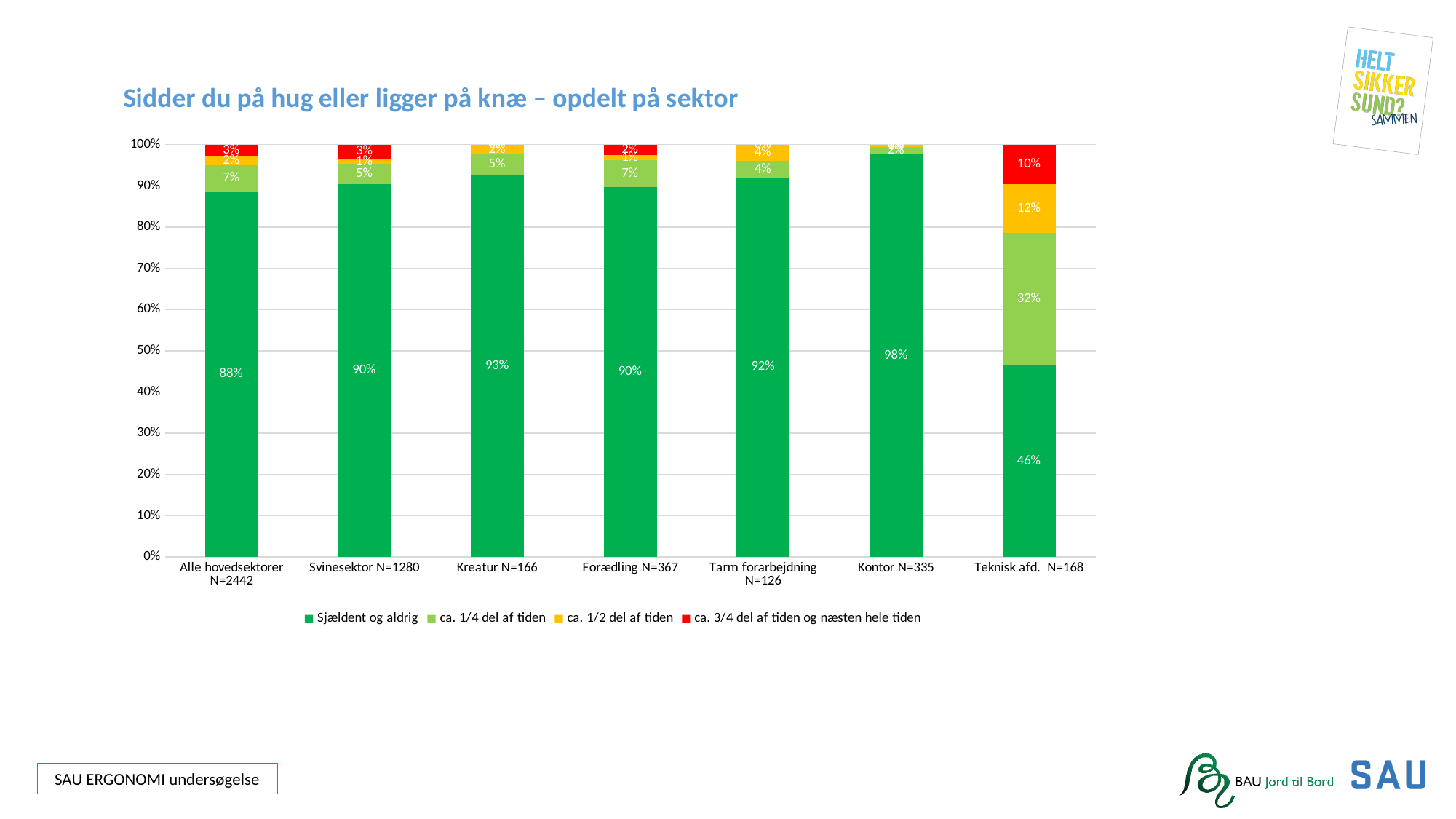
Which category has the highest value for "Sjældent og aldrig"? Kontor N=335 What is the value for "Sjældent og aldrig" in the Alle hovedsektorer N=2442 category? 88% How many series does the legend list? 4 Which is larger: the "Sjældent og aldrig" value for Kreatur N=166 or for Svinesektor N=1280? Kreatur N=166 Which category has the lowest value for "Sjældent og aldrig"? Teknisk afd. N=168 What is the value for "ca. 3/4 del af tiden og næsten hele tiden" in the Teknisk afd. N=168 category? 10% What kind of chart is shown on the slide? Stacked bar chart What is the value for "Sjældent og aldrig" in the Kontor N=335 category? 98% How many categories are shown on the x axis? 7 What is the value for "Sjældent og aldrig" in the Teknisk afd. N=168 category? 46% What is the value for "ca. 1/4 del af tiden" in the Teknisk afd. N=168 category? 32% What is the difference between the "Sjældent og aldrig" values for Kontor N=335 and Teknisk afd. N=168? 52%